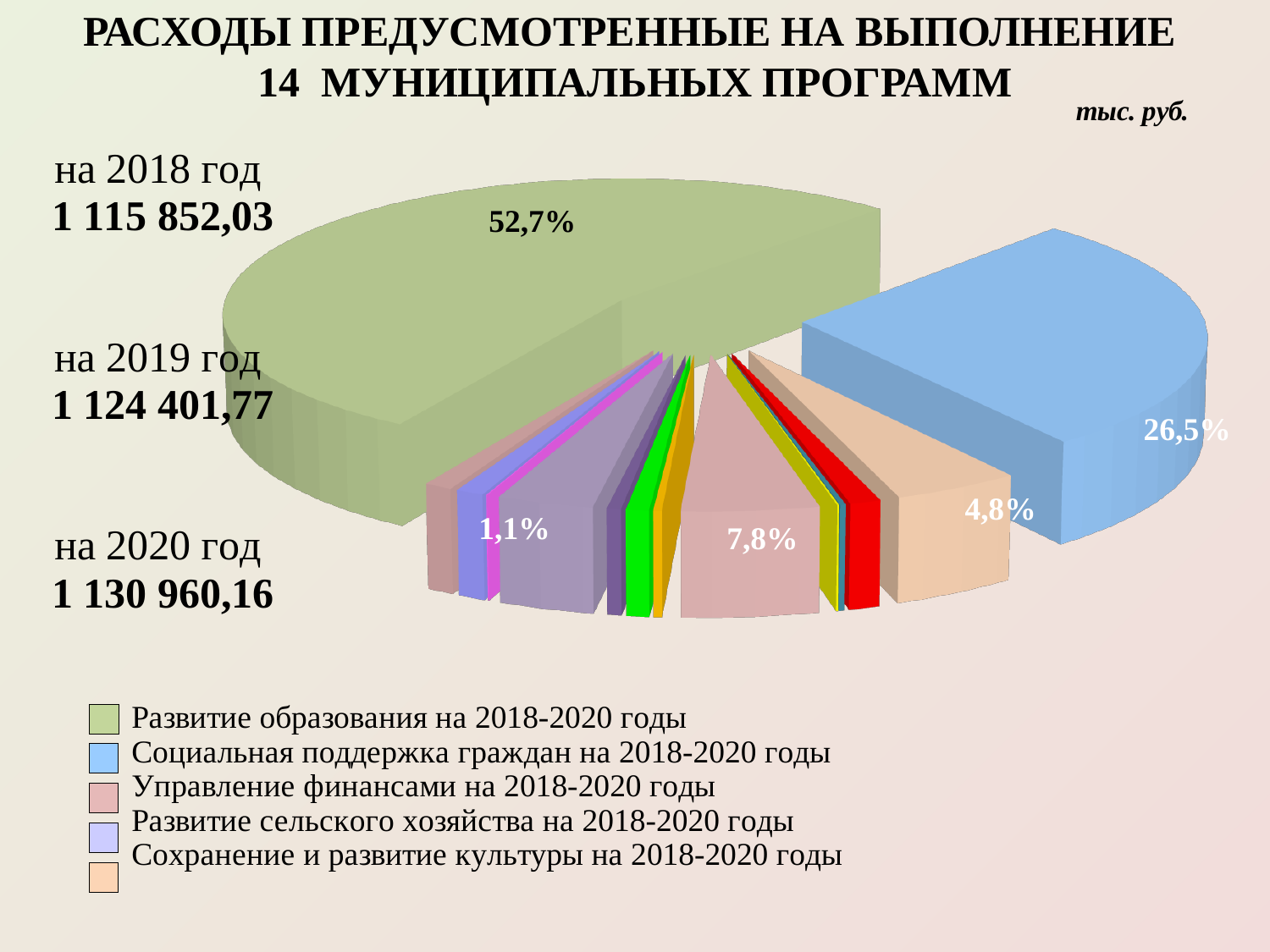
How many percentage labels are printed on the pie chart? 5 What is the total expenditure shown for 2019 (на 2019 год)? 1 124 401,77 What kind of chart is shown on the slide? pie chart Which is larger: the slice labelled 7,8% or the slice labelled 4,8%? 7,8% What unit is indicated in the top right of the slide? тыс. руб. What is the smallest percentage printed on the pie chart? 1,1% Which legend entry corresponds to the largest slice of the pie? Развитие образования на 2018-2020 годы How many labelled entries does the legend list? 5 What is the difference between the 52,7% slice and the 26,5% slice? 26,2% What is the total expenditure shown for 2020 (на 2020 год)? 1 130 960,16 What share of the pie is labelled for the blue slice? 26,5% What share of the pie does the largest slice (green) represent? 52,7%